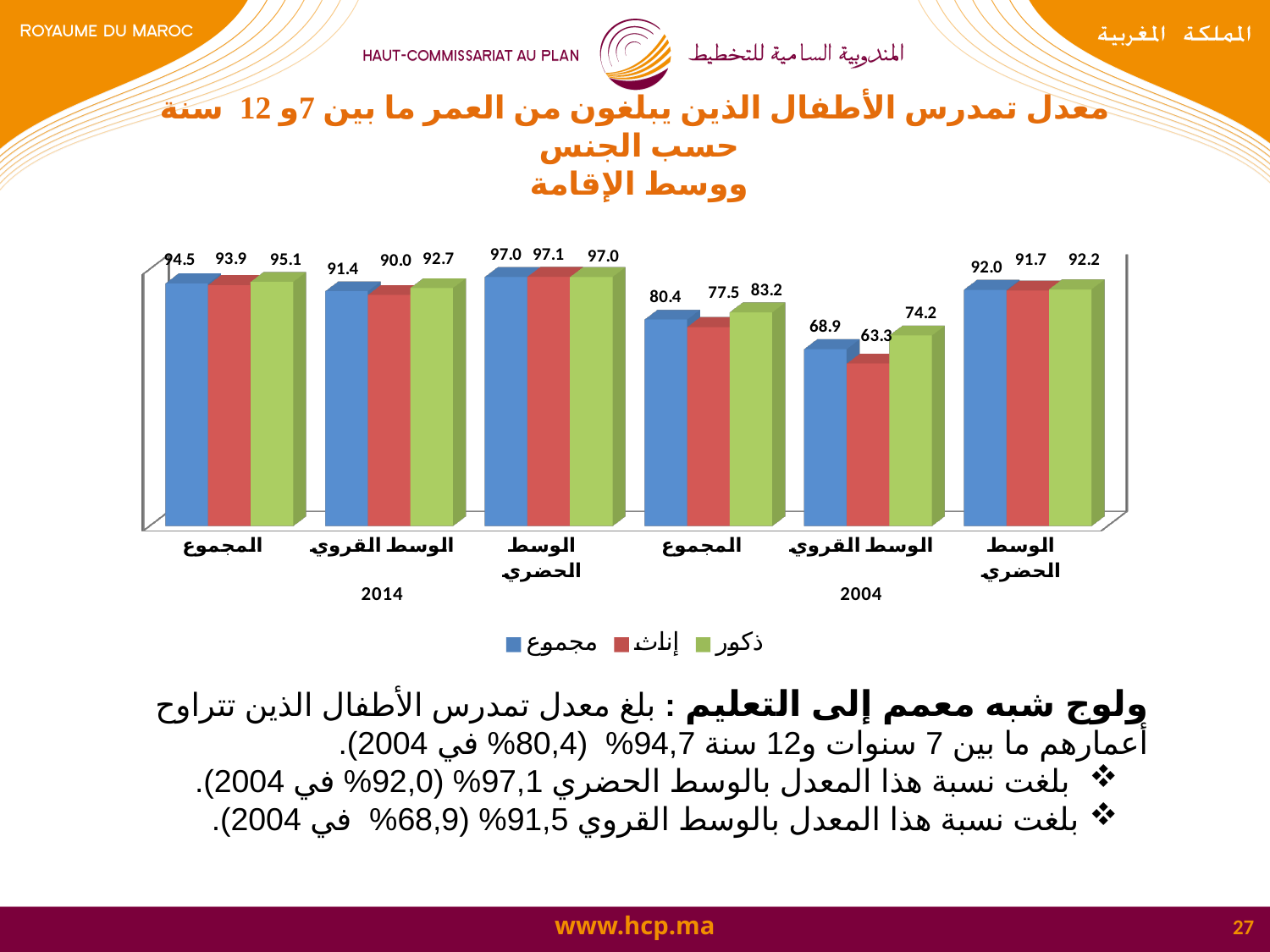
Which legend entry is shown in green? ذكور Which category group has the highest values in the chart? الوسط الحضري 2014 What is the value of the blue (مجموع) bar for الوسط القروي in 2004? 68.9 How many series does the legend list? 3 What kind of chart is shown on the slide? bar chart Which is larger: the red (إناث) bar for المجموع in 2004 or the green (ذكور) bar for المجموع in 2004? ذكور (83.2) What is the difference between the blue (مجموع) bars for الوسط القروي in 2014 and 2004? 22.5 Which bar has the lowest value in the chart? إناث, الوسط القروي, 2004 (63.3) How many category groups are plotted along the x axis? 6 What is the value of the green (ذكور) bar for المجموع in 2004? 83.2 What is the value of the blue (مجموع) bar for المجموع in 2014? 94.5 What is the value of the red (إناث) bar for الوسط الحضري in 2014? 97.1